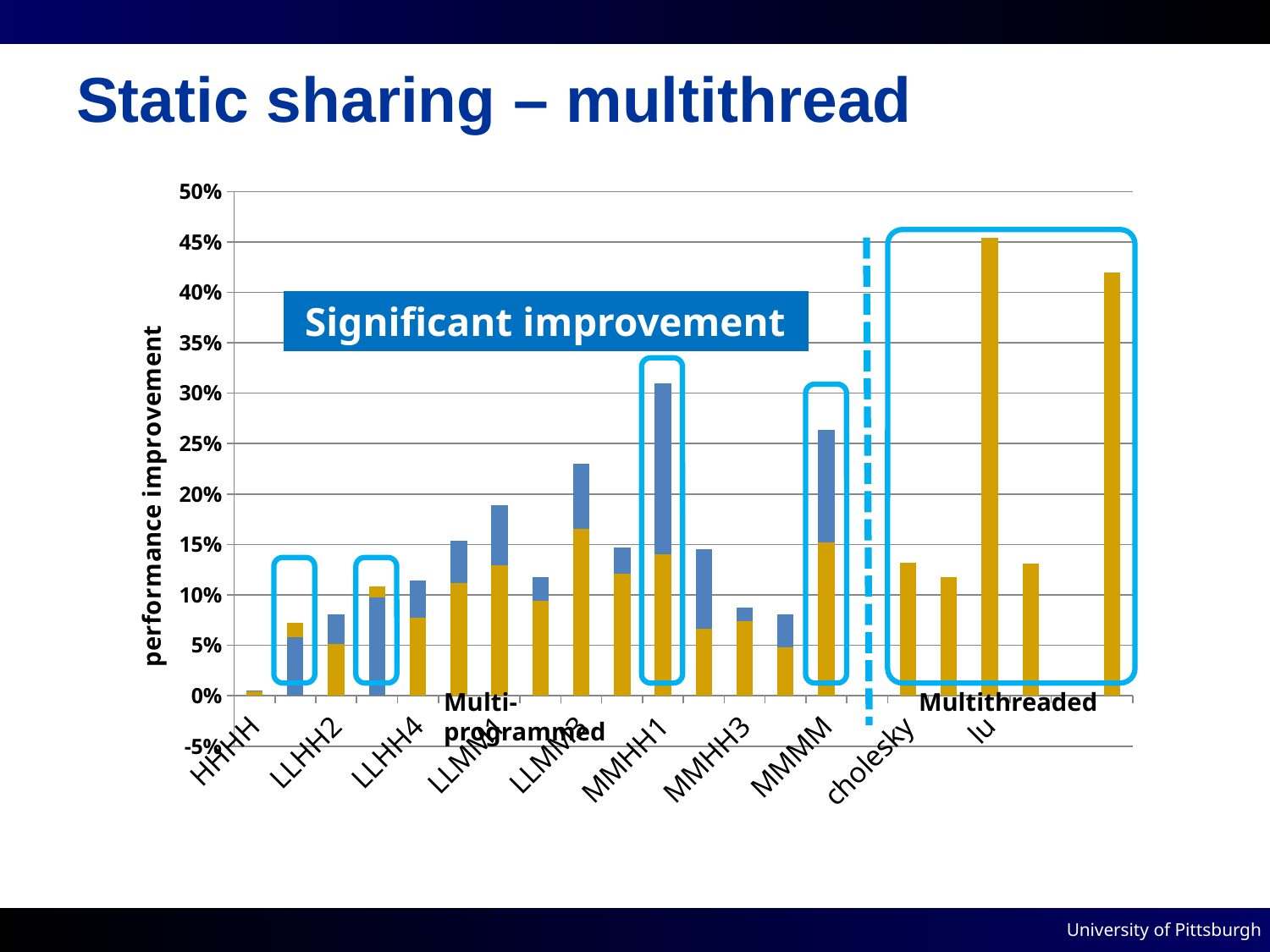
Which is larger, the bar for lu or the bar for cholesky? lu What kind of chart is shown on the slide? bar chart Which labelled category has the lowest bar? HHHH Is the total for MMHH1 greater or less than 25%? greater Which category has the highest bar? lu What is the title of the vertical axis? performance improvement Is the total for MMMM greater or less than 20%? greater Is the value for lu greater or less than 40%? greater What text appears in the highlighted box overlaid on the chart? Significant improvement Which is larger, the total bar for MMHH1 or the total bar for LLHH2? MMHH1